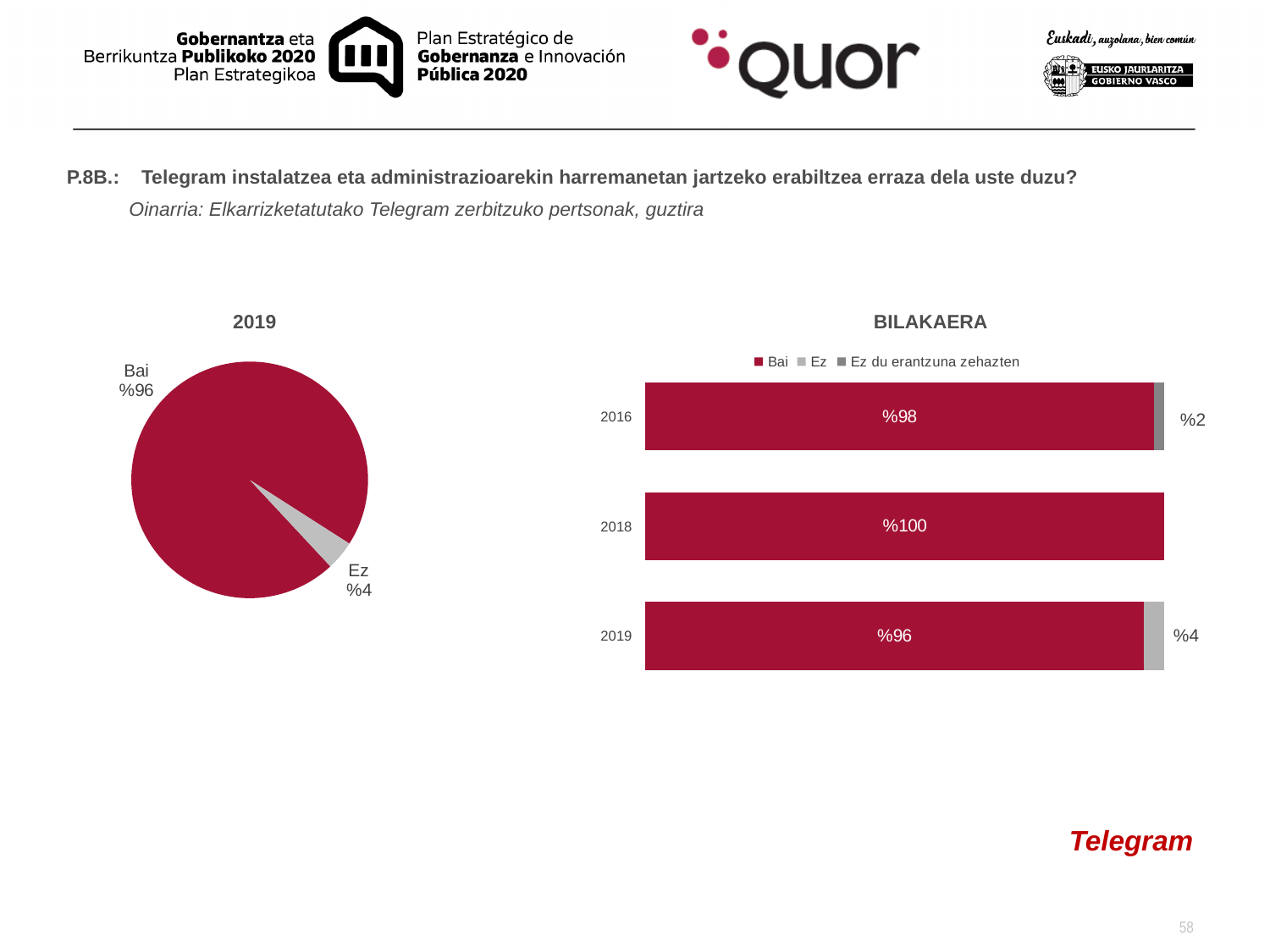
In the BILAKAERA chart, how many series does the legend list? 3 In the BILAKAERA chart, what is the Ez value for 2019? %4 In the pie chart titled 2019, what is the value for Bai? %96 What kind of chart is the chart on the left titled 2019? pie chart In the BILAKAERA chart, which year has the highest Bai value? 2018 In the pie chart titled 2019, which slice is the largest? Bai What kind of chart is the chart titled BILAKAERA? bar chart In the BILAKAERA chart, what is the Bai value for 2018? %100 In the pie chart titled 2019, what is the value for Ez? %4 In the BILAKAERA chart, what is the Bai value for 2016? %98 In the pie chart titled 2019, how many slices are there? 2 In the BILAKAERA chart, what is the difference between the Bai value for 2016 and the Bai value for 2019? %2